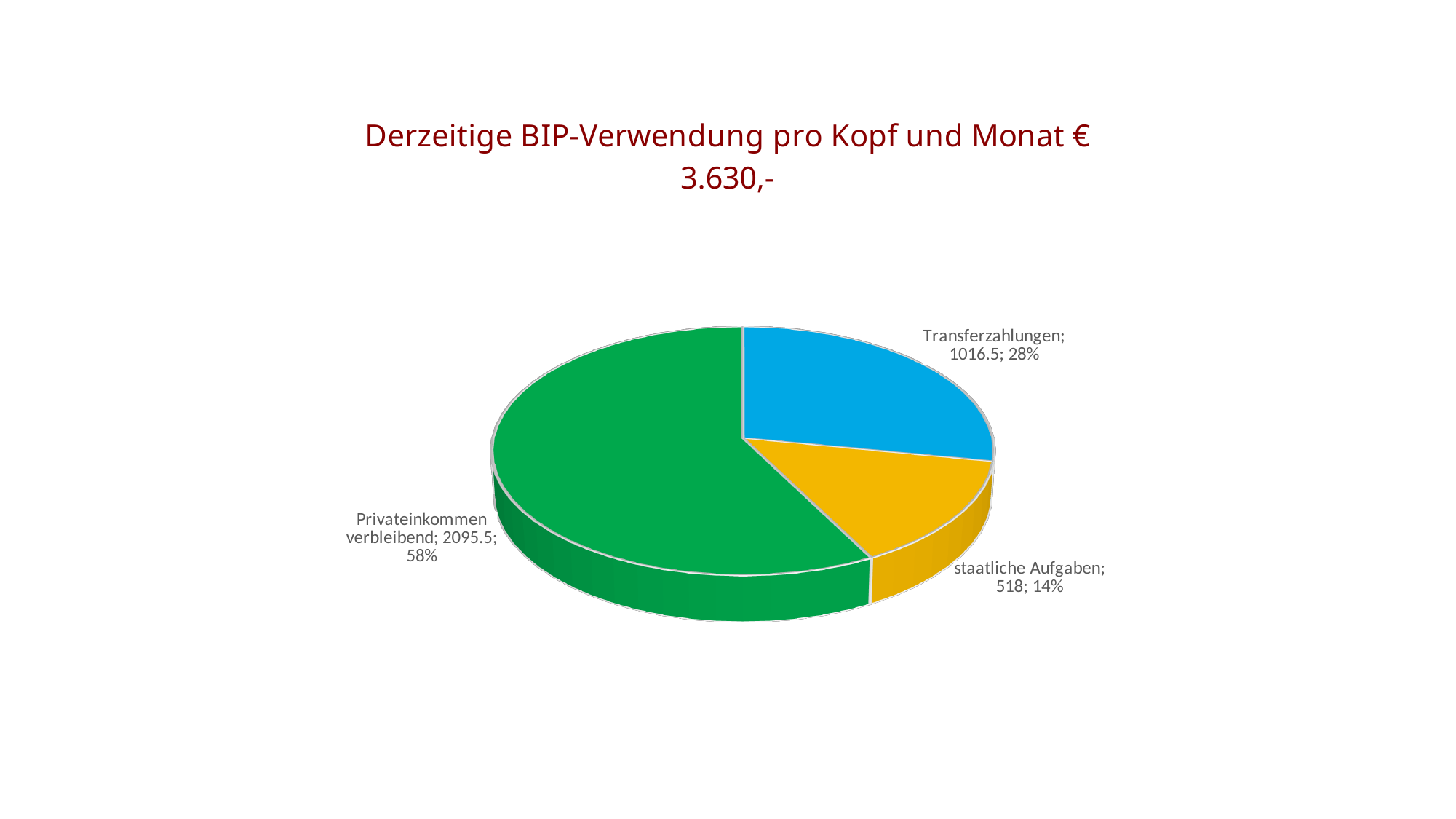
Which is larger, Transferzahlungen or staatliche Aufgaben? Transferzahlungen What is the value for Transferzahlungen? 1016.5 What share of the pie does Transferzahlungen represent? 28% What kind of chart is shown on the slide? pie chart What is the title of the chart? Derzeitige BIP-Verwendung pro Kopf und Monat € 3.630,- Which category has the largest slice? Privateinkommen verbleibend What share of the pie does staatliche Aufgaben represent? 14% Which category has the smallest slice? staatliche Aufgaben What is the value for Privateinkommen verbleibend? 2095.5 How many slices does the pie chart have? 3 What is the value for staatliche Aufgaben? 518 What is the difference between the values for Transferzahlungen and staatliche Aufgaben? 498.5